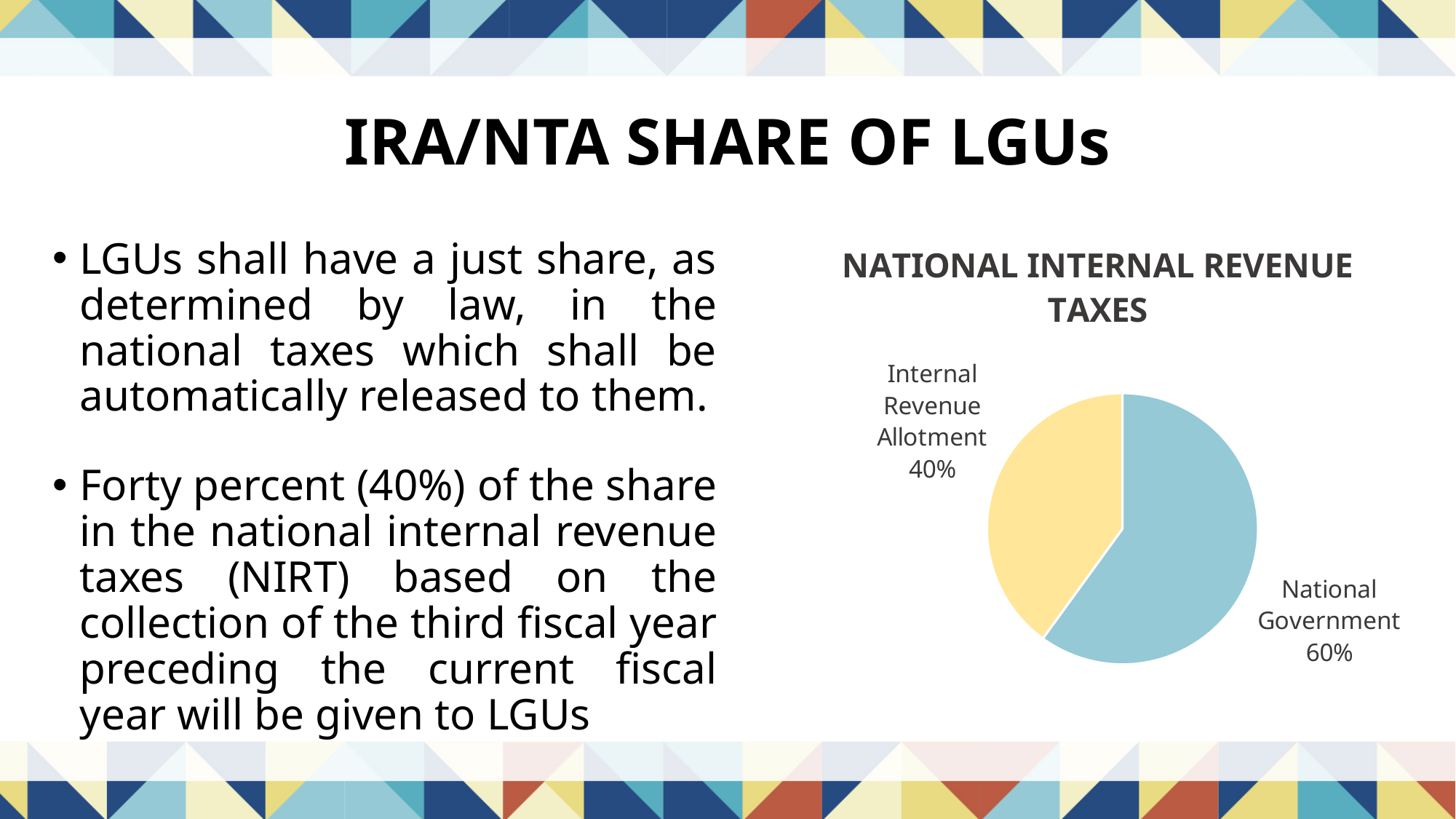
How many slices does the pie chart have? 2 What is the total of the two slices shown in the pie chart? 100% What colour is the Internal Revenue Allotment slice? yellow Which slice of the pie is the smallest? Internal Revenue Allotment What share of the pie is labelled Internal Revenue Allotment? 40% Which slice of the pie is the largest? National Government Which is larger, the National Government share or the Internal Revenue Allotment share? National Government What is the difference in percentage points between the National Government share and the Internal Revenue Allotment share? 20% What is the title of the chart? NATIONAL INTERNAL REVENUE TAXES What kind of chart is shown on the slide? pie chart What share of the pie is labelled National Government? 60%